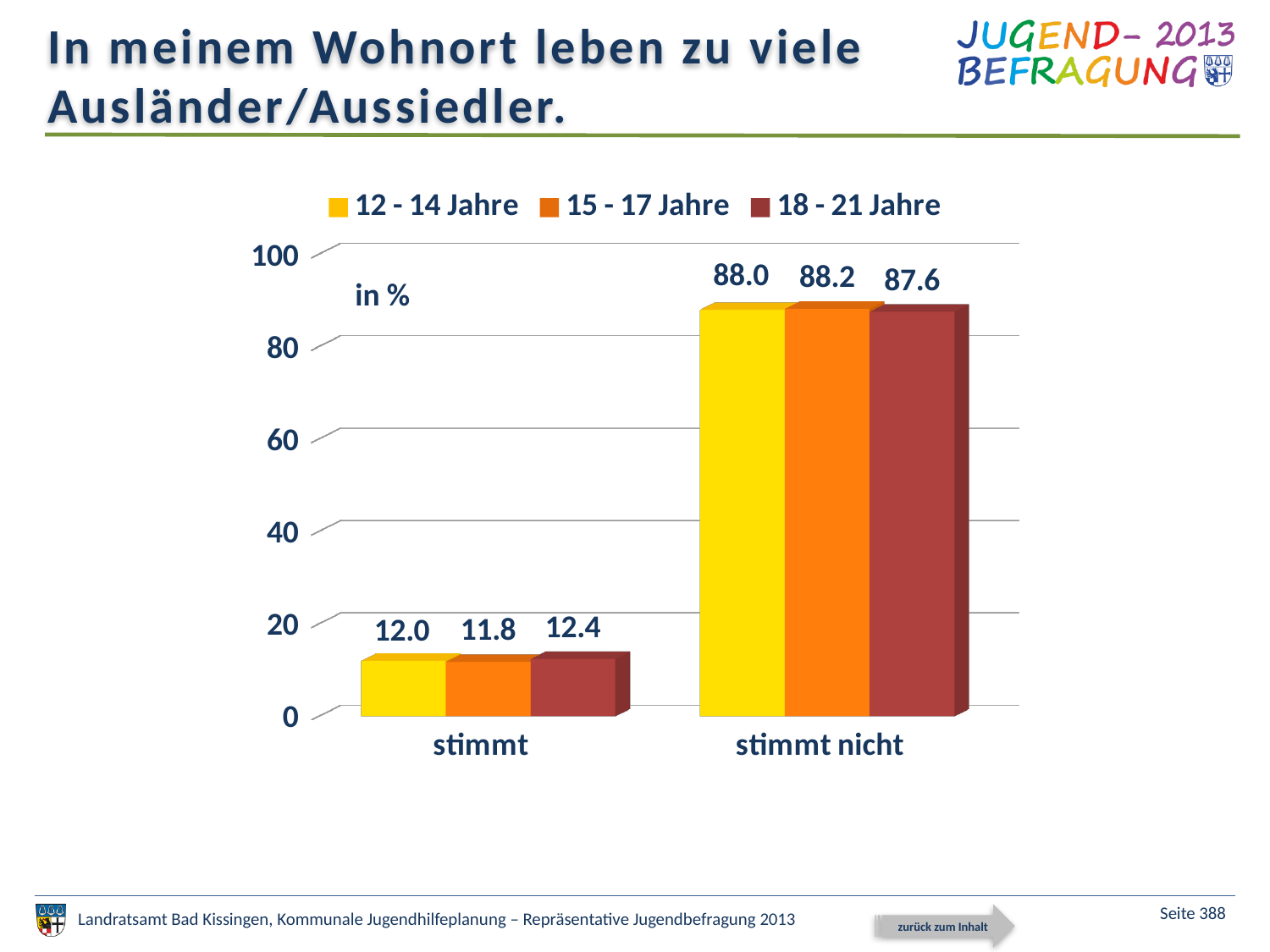
What is the value for the 18 - 21 Jahre series in the 'stimmt nicht' category? 87.6 What is the value for the 12 - 14 Jahre series in the 'stimmt' category? 12.0 What unit is indicated on the chart? in % How many categories are shown on the x axis? 2 What kind of chart is shown on the slide? bar chart Which is larger: the 15 - 17 Jahre value for 'stimmt nicht' or the 18 - 21 Jahre value for 'stimmt nicht'? 15 - 17 Jahre Which age group has the highest value in the 'stimmt' category? 18 - 21 Jahre What is the difference between the 'stimmt nicht' and 'stimmt' values for the 12 - 14 Jahre series? 76.0 Which age group has the lowest value in the 'stimmt' category? 15 - 17 Jahre What is the value for the 15 - 17 Jahre series in the 'stimmt nicht' category? 88.2 How many series does the legend list? 3 Is the value for 18 - 21 Jahre in the 'stimmt' category greater or less than 20? less